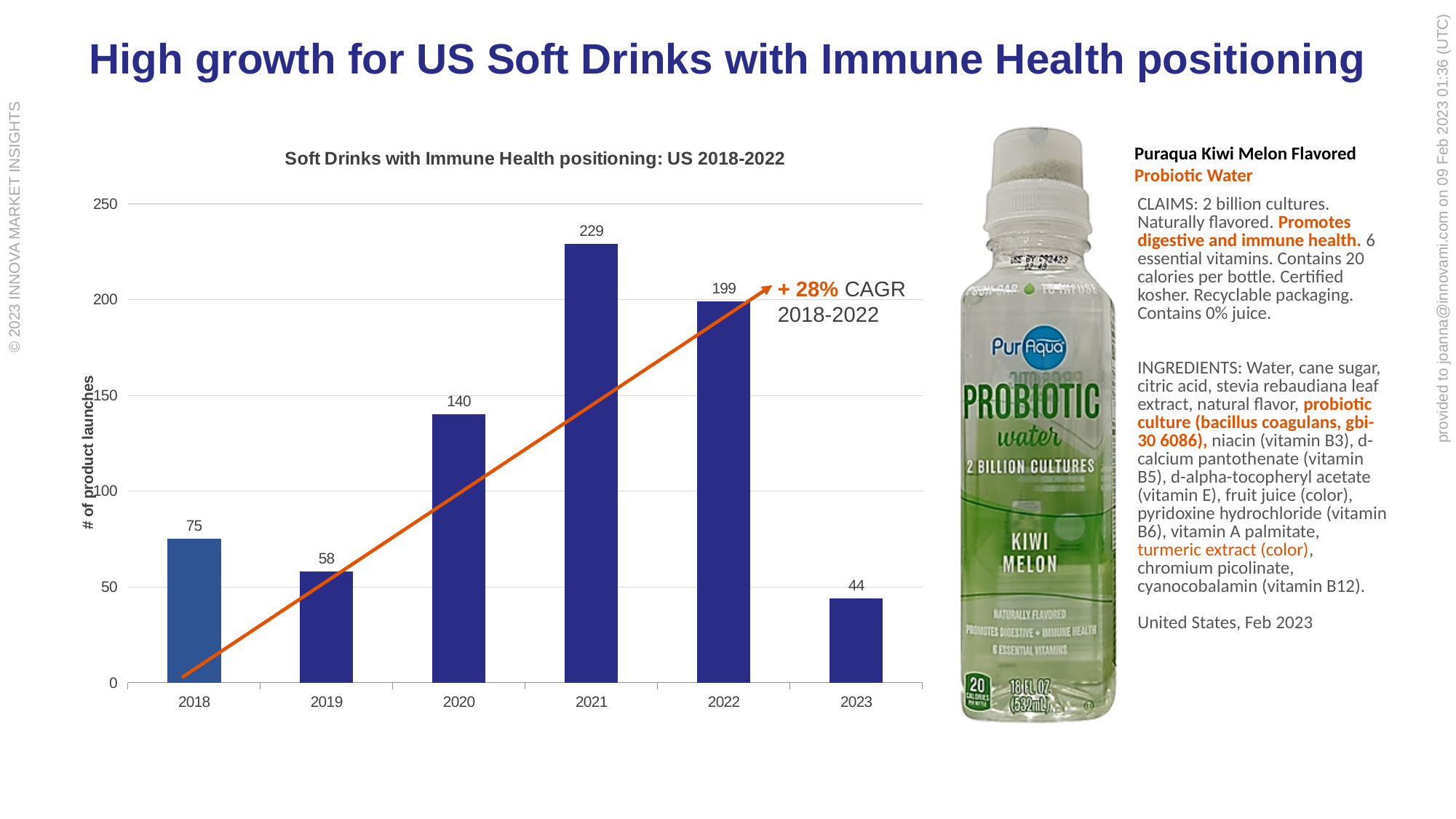
What is the difference in product launches between 2020 and 2019? 82 What is the difference in product launches between 2021 and 2022? 30 What kind of chart is shown on the slide? Bar chart How many years are shown on the x axis of the chart? 6 What is the number of product launches in 2018? 75 What is the number of product launches in 2021? 229 Which year has more product launches, 2018 or 2019? 2018 What is the title of the chart? Soft Drinks with Immune Health positioning: US 2018-2022 Which year has the lowest number of product launches? 2023 Which year has the highest number of product launches? 2021 What CAGR for 2018-2022 is annotated on the chart? + 28% What is the number of product launches in 2023? 44